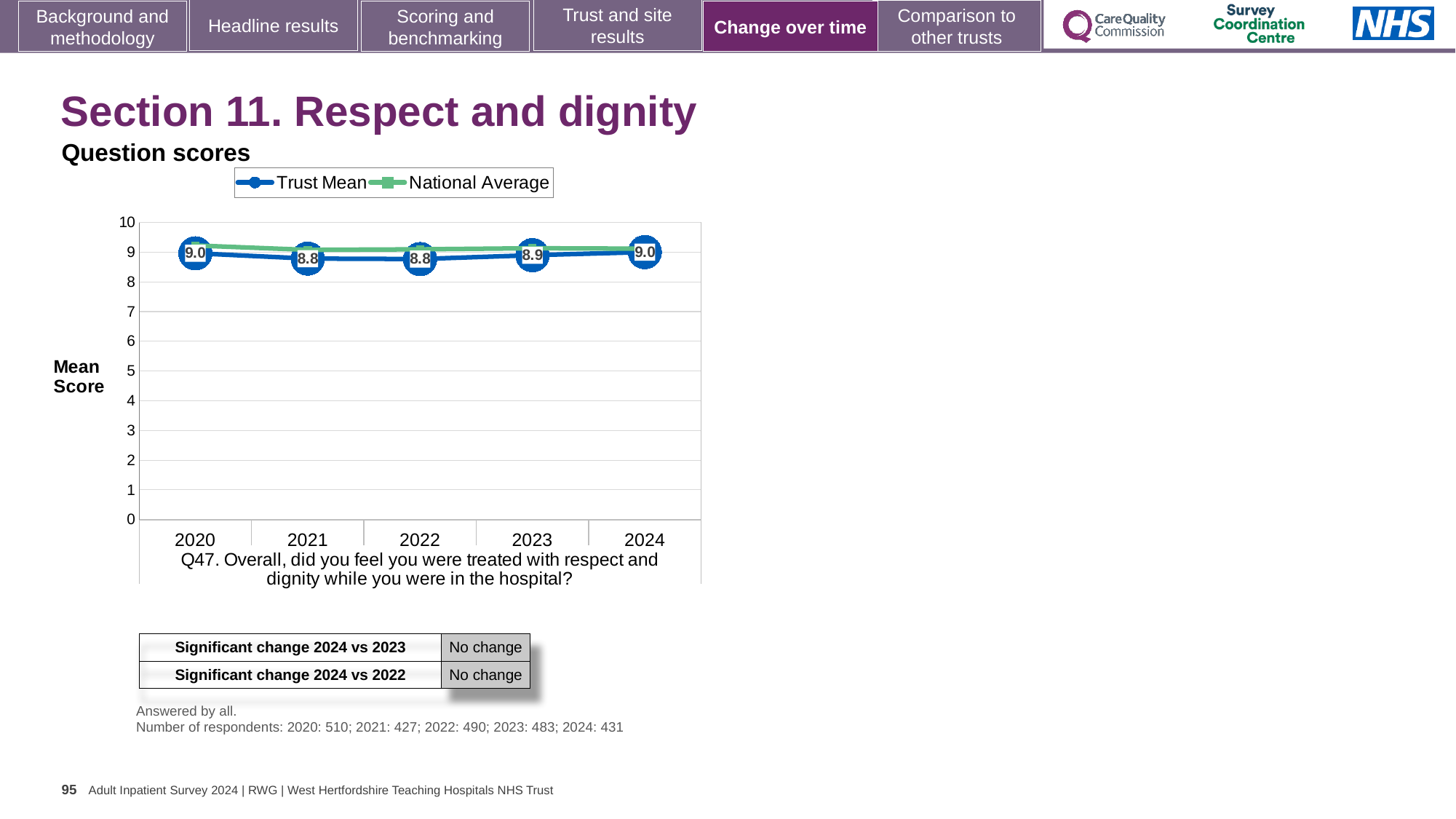
Does the Trust Mean rise or fall from 2022 to 2024? Rise Is the Trust Mean value for 2022 greater or less than 9? less What is the Trust Mean score for 2023? 8.9 What kind of chart is shown? Line chart What is the Trust Mean score for 2021? 8.8 Is the National Average value for 2020 greater or less than 9? greater How many years are plotted on the x axis? 5 What is the Trust Mean score for 2024? 9.0 Which year has the larger Trust Mean score, 2021 or 2023? 2023 What is the difference between the Trust Mean scores for 2024 and 2021? 0.2 What is the Trust Mean score for 2020? 9.0 How many series does the legend list? 2